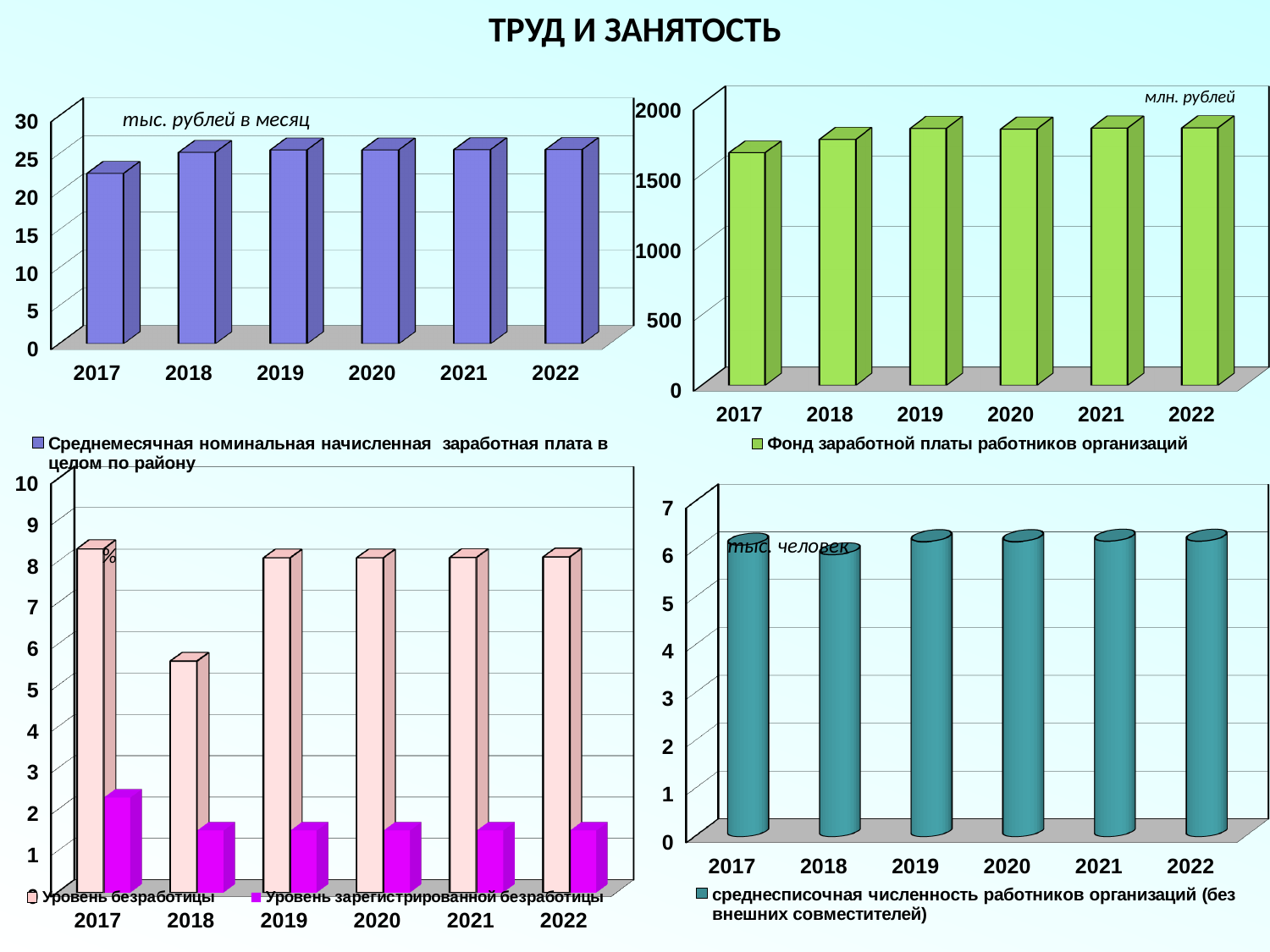
On the top-right chart (wage fund of organisations' employees), what unit is indicated in the chart? млн. рублей On the top-left chart (average monthly nominal wage), how many years are shown on the x axis? 6 On the bottom-left chart (unemployment rates), which year has the highest value for 'Уровень зарегистрированной безработицы'? 2017 On the top-right chart (wage fund of organisations' employees), which year has the lowest value? 2017 On the bottom-right chart (average headcount of organisations' employees), is the value for 2017 greater or less than 5? greater On the bottom-left chart (unemployment rates), which year has the lowest value for 'Уровень безработицы'? 2018 What kind of chart is the bottom-right chart (average headcount of organisations' employees)? bar chart On the top-right chart (wage fund of organisations' employees), is the value for 2022 greater or less than 1500? greater On the bottom-left chart (unemployment rates), how many series does the legend list? 2 On the top-left chart (average monthly nominal wage), which year has the lowest value? 2017 On the bottom-left chart (unemployment rates), is the value of 'Уровень безработицы' for 2018 greater or less than 6? less